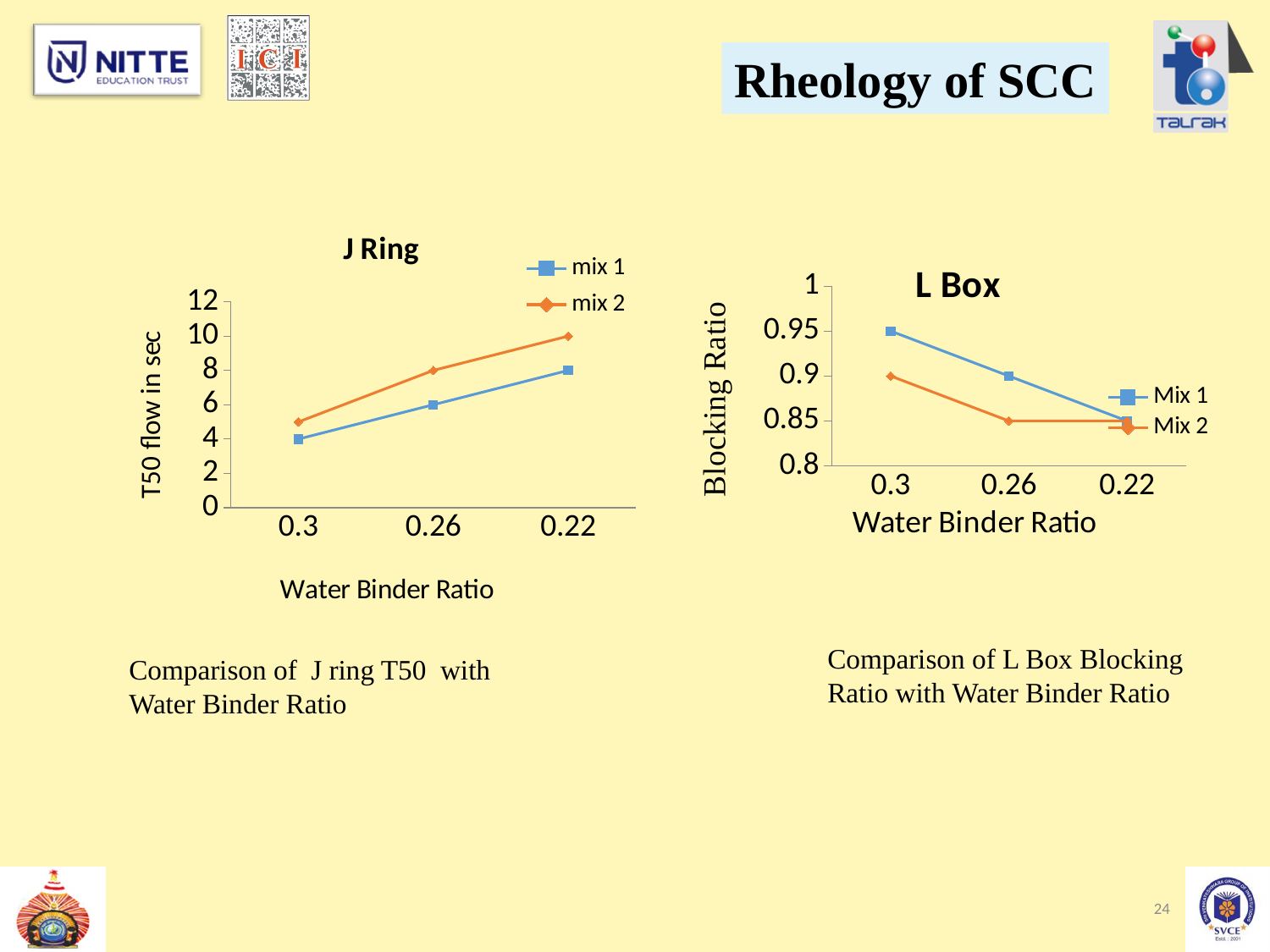
In the J Ring chart, what is the T50 flow for mix 1 at a water binder ratio of 0.3? 4 In the L Box chart, what is the blocking ratio for Mix 1 at a water binder ratio of 0.3? 0.95 In the J Ring chart, do the T50 flow values for mix 1 rise or fall from left to right along the x axis? rise In the J Ring chart, what is the T50 flow for mix 2 at a water binder ratio of 0.22? 10 In the L Box chart, do the blocking ratio values for Mix 1 rise or fall from left to right along the x axis? fall In the J Ring chart, what is the difference between the T50 flow of mix 2 and mix 1 at a water binder ratio of 0.22? 2 How many water binder ratio values are plotted on the x axis of the J Ring chart? 3 What kind of chart is the J Ring chart? line chart In the L Box chart, what is the blocking ratio for Mix 2 at a water binder ratio of 0.26? 0.85 In the J Ring chart, is the T50 flow for mix 2 at a water binder ratio of 0.3 greater or less than 6? less In the J Ring chart, which series has the higher T50 flow at a water binder ratio of 0.26, mix 1 or mix 2? mix 2 How many series does the legend of the L Box chart list? 2